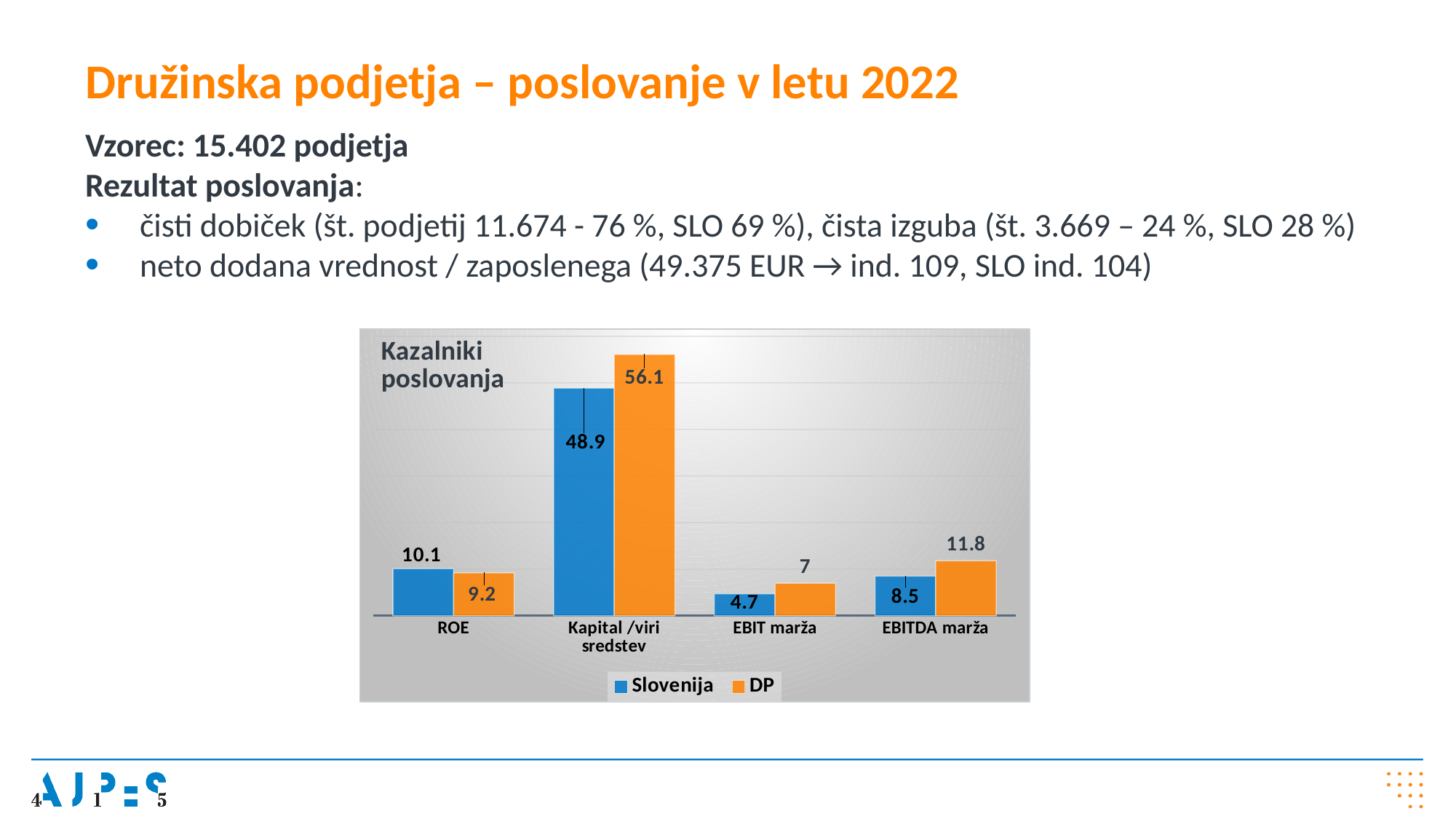
How many categories are shown on the x axis? 4 What is the difference between the DP and Slovenija values for EBITDA marža? 3.3 What is the Slovenija value for ROE? 10.1 What is the Slovenija value for EBITDA marža? 8.5 What type of chart is shown on the slide? Bar chart Which category has the lowest Slovenija value? EBIT marža What is the DP value for EBIT marža? 7 For ROE, which is larger: the Slovenija value or the DP value? Slovenija How many series does the legend list? 2 Which category has the highest DP value? Kapital /viri sredstev What is the difference between the DP and Slovenija values for Kapital /viri sredstev? 7.2 What is the DP value for Kapital /viri sredstev? 56.1